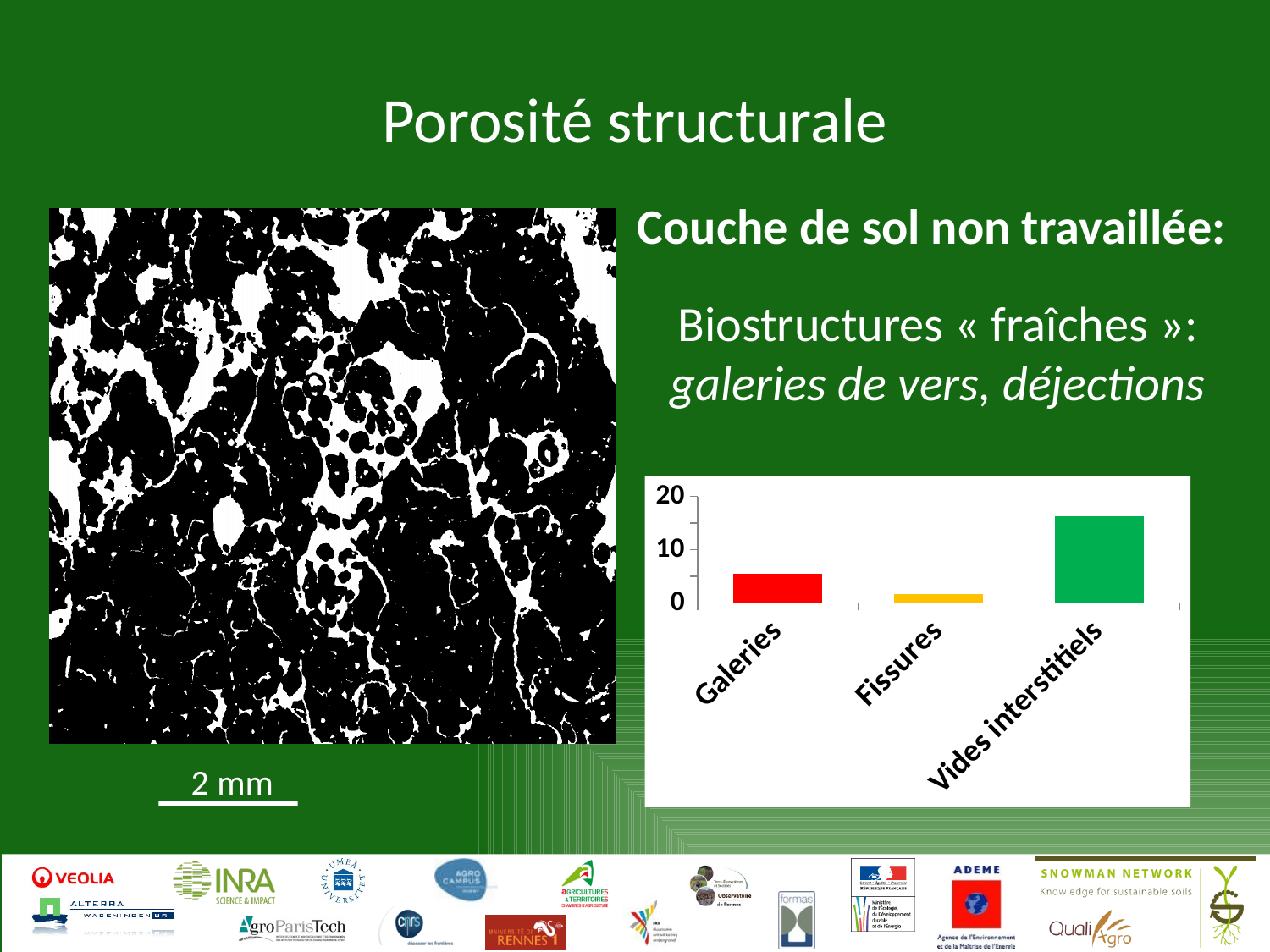
Is the value for Galeries greater or less than 10? less Which is larger, the value for Galeries or the value for Vides interstitiels? Vides interstitiels Is the value for Vides interstitiels greater or less than 10? greater Which category has the lowest bar in the chart? Fissures How many categories are shown on the x axis of the bar chart? 3 Which is larger, the value for Galeries or the value for Fissures? Galeries Is the value for Vides interstitiels greater or less than 20? less What colour is the bar for Vides interstitiels? green What colour is the bar for Galeries? red Which category has the highest bar in the chart? Vides interstitiels What kind of chart is shown on the slide? bar chart